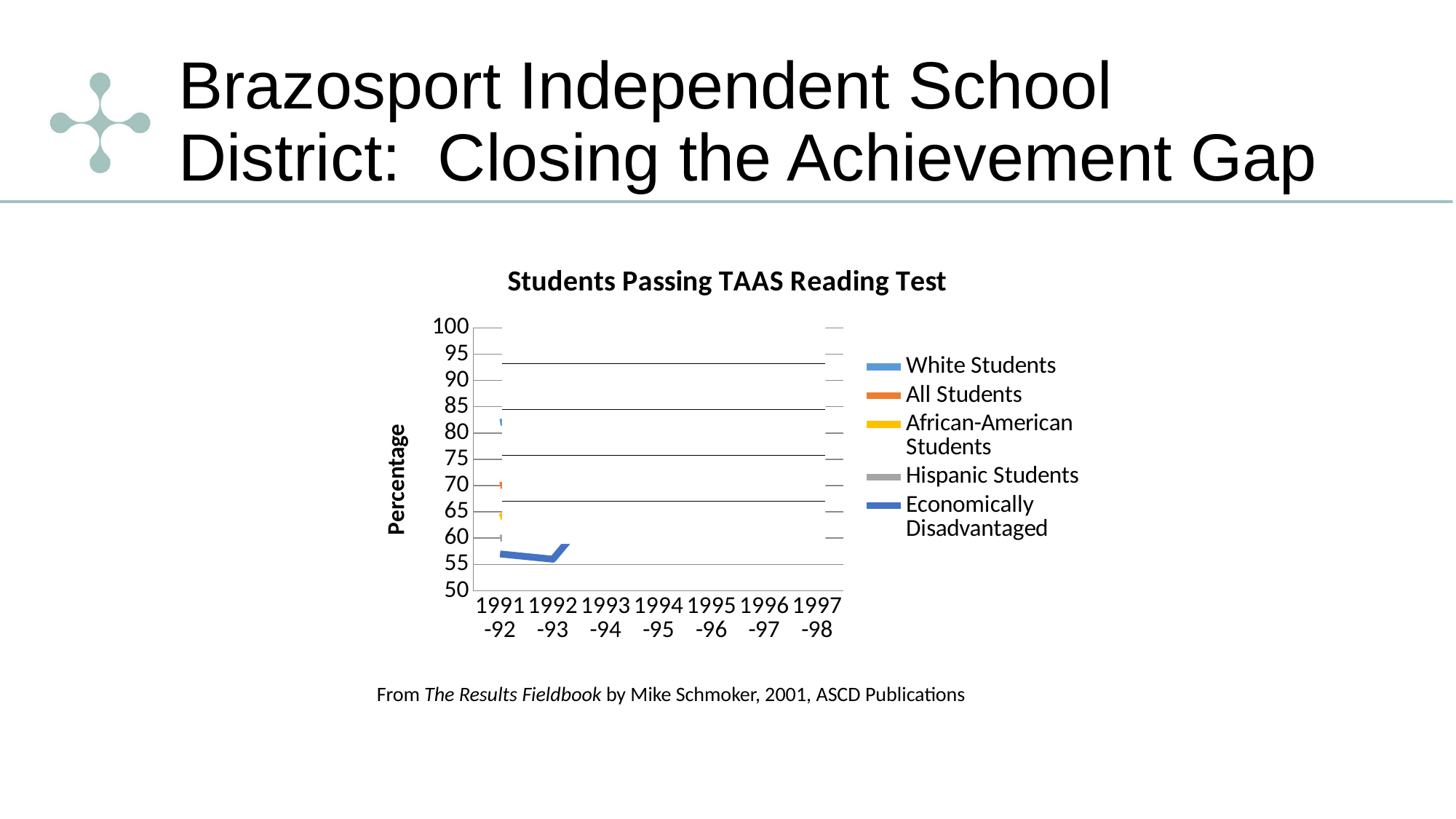
How many series does the chart's legend list? 5 What is the label on the vertical axis of the chart? Percentage What kind of chart is shown on the slide? line chart In 1991-92, which is larger: the value for White Students or the value for Economically Disadvantaged students? White Students Is the value for Economically Disadvantaged students in 1992-93 greater or less than 60? less Is the value for All Students in 1991-92 greater or less than 65? greater Does the Economically Disadvantaged line rise or fall from 1991-92 to 1992-93? fall Which series has the lowest value in 1991-92? Economically Disadvantaged How many school years are shown along the x axis of the chart? 7 Is the value for White Students in 1991-92 greater or less than 75? greater What is the title of the chart? Students Passing TAAS Reading Test